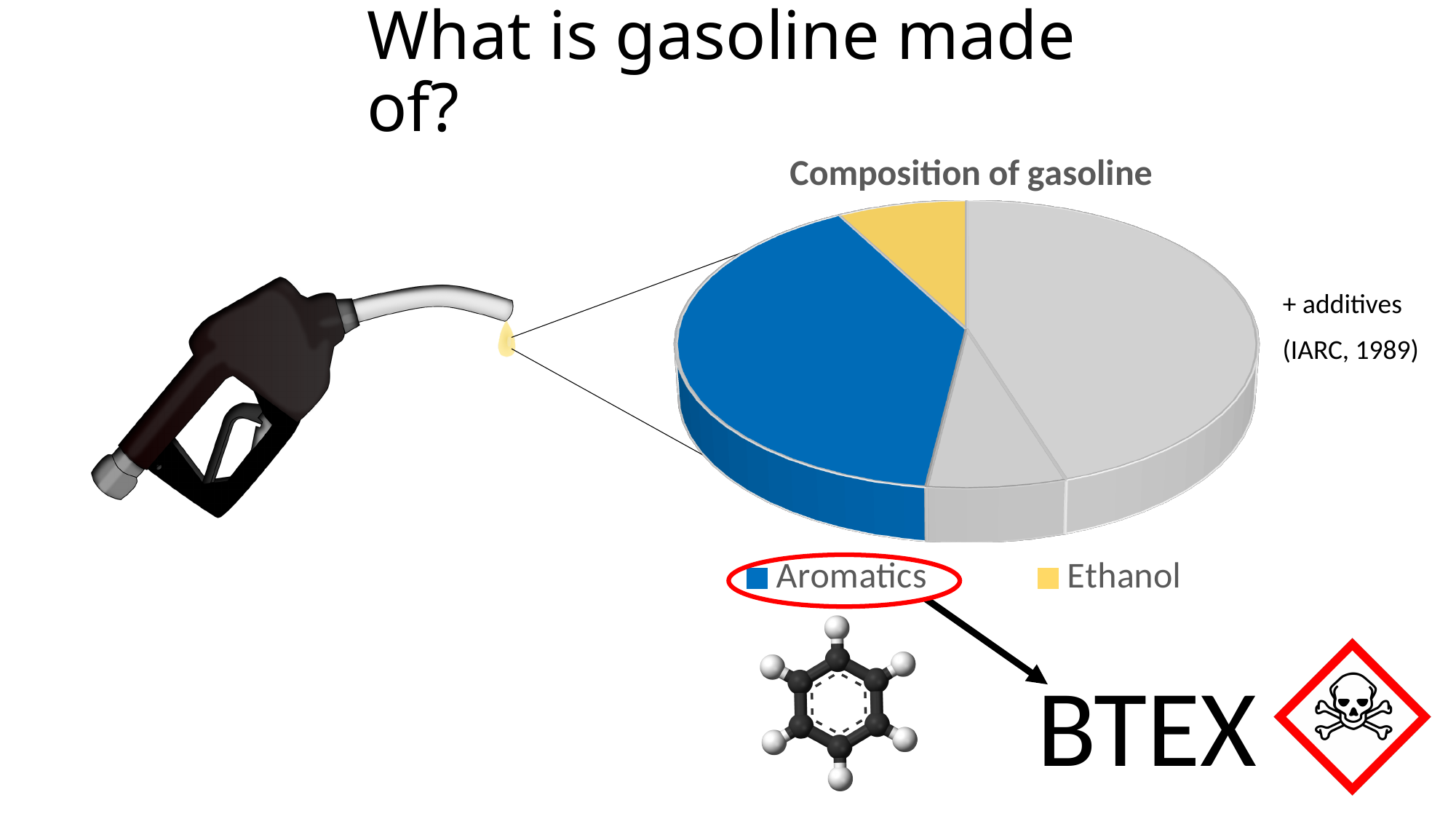
How many slices does the pie chart have? 4 What kind of chart is shown on the slide? pie chart What is the title of the chart? Composition of gasoline Of the slices named in the legend, which is the smallest? Ethanol How many entries does the chart's legend list? 2 Which is larger in the pie chart, the Aromatics slice or the Ethanol slice? Aromatics Which legend entry is circled in red on the slide? Aromatics